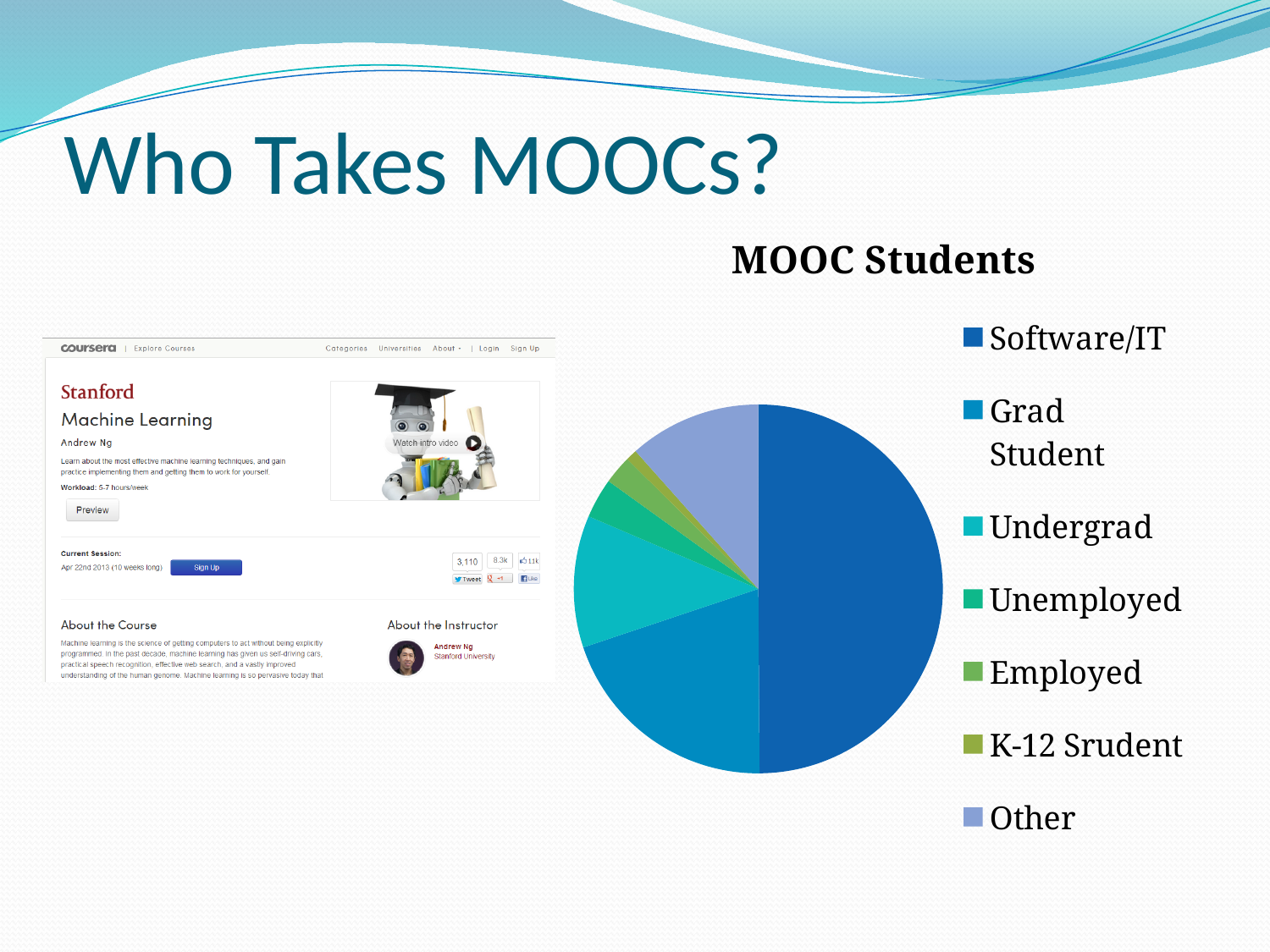
What colour is the Software/IT slice in the pie chart? Dark blue Which slice is larger, Software/IT or Other? Software/IT How many categories does the pie chart show? 7 Which category has the largest slice of the pie? Software/IT What kind of chart is shown on the slide? Pie chart How many entries does the chart's legend list? 7 Which slice is larger, Grad Student or Undergrad? Grad Student What is the title of the chart? MOOC Students Which slice is larger, Other or K-12 Srudent? Other